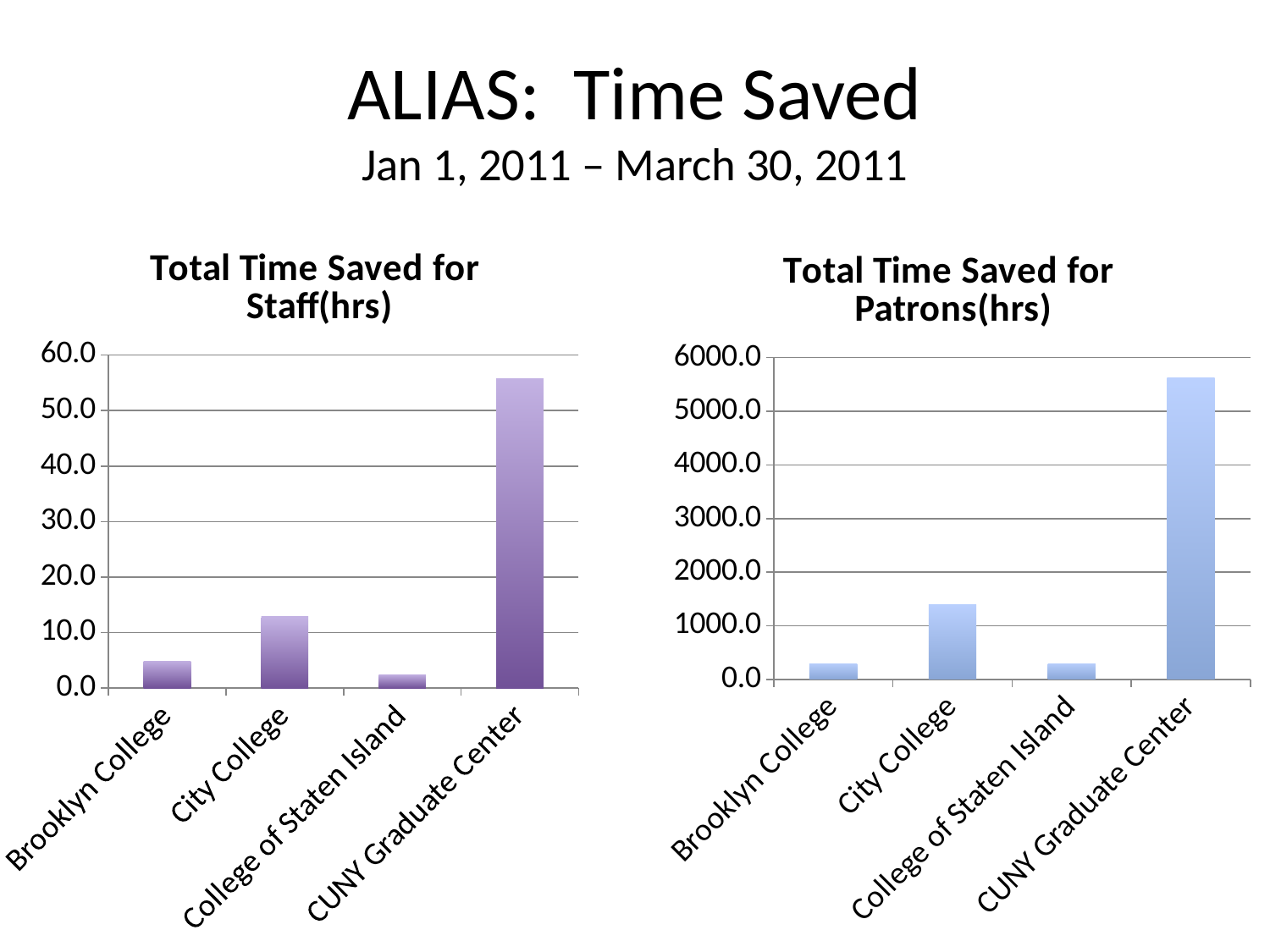
In the 'Total Time Saved for Staff(hrs)' chart, which college has the lowest value? College of Staten Island In the 'Total Time Saved for Patrons(hrs)' chart, is the value for City College greater or less than 1000.0? greater What is the title of the chart on the right side of the slide? Total Time Saved for Patrons(hrs) In the 'Total Time Saved for Patrons(hrs)' chart, which college has the highest value? CUNY Graduate Center In the 'Total Time Saved for Staff(hrs)' chart, is the value for CUNY Graduate Center greater or less than 50.0? greater In the 'Total Time Saved for Staff(hrs)' chart, which college has the highest value? CUNY Graduate Center In the 'Total Time Saved for Staff(hrs)' chart, is the value for City College greater or less than 10.0? greater In the 'Total Time Saved for Patrons(hrs)' chart, which is larger, the value for City College or the value for College of Staten Island? City College How many colleges are shown in the 'Total Time Saved for Staff(hrs)' chart? 4 In the 'Total Time Saved for Staff(hrs)' chart, which is larger, the value for City College or the value for Brooklyn College? City College What kind of chart is the 'Total Time Saved for Patrons(hrs)' chart? Bar chart